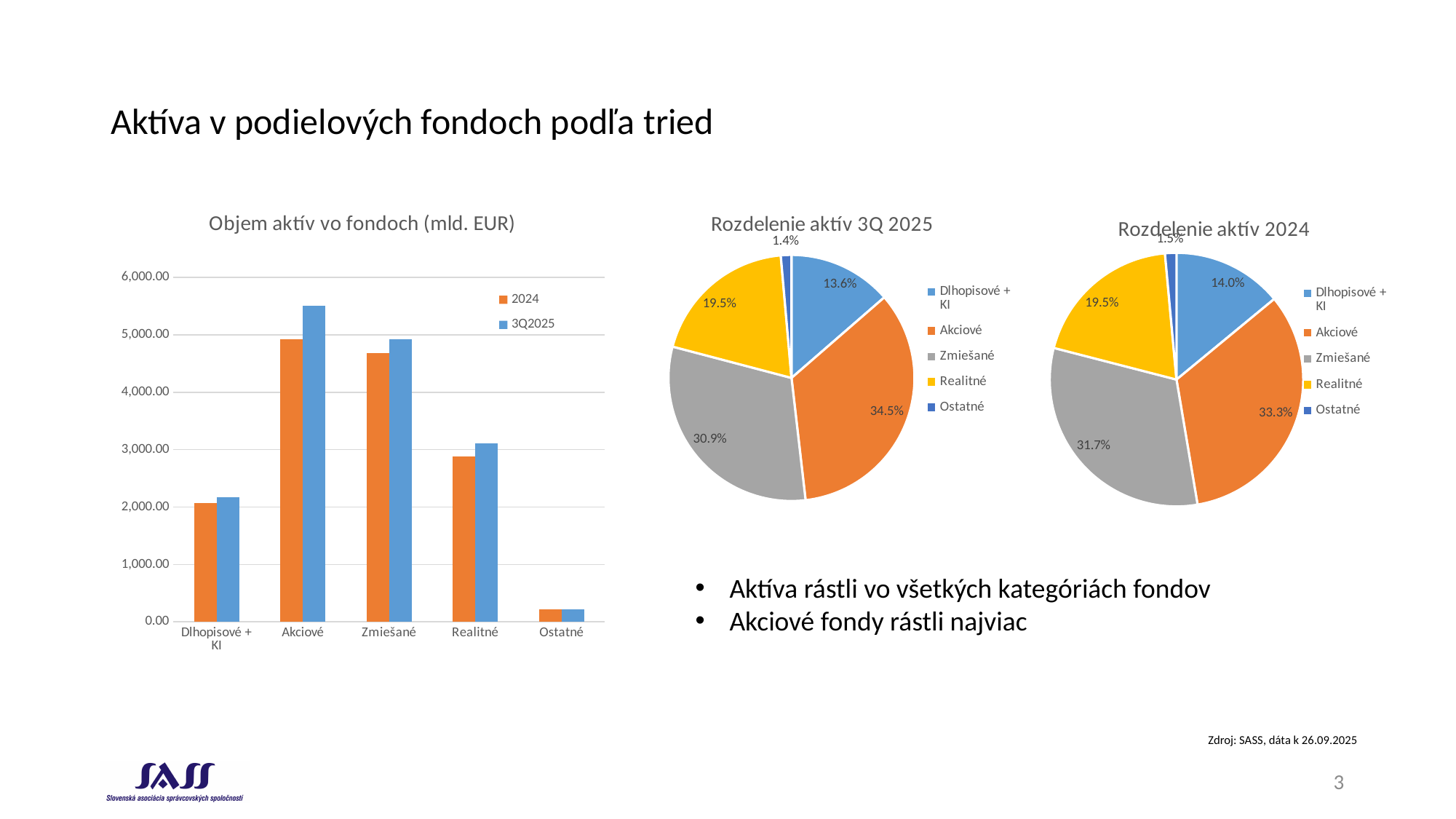
In the chart 'Objem aktív vo fondoch (mld. EUR)', which category has the lowest values? Ostatné In the chart 'Rozdelenie aktív 3Q 2025', what share do Akciové funds have? 34.5% What kind of chart is 'Objem aktív vo fondoch (mld. EUR)'? Bar chart In the chart 'Objem aktív vo fondoch (mld. EUR)', is the 3Q2025 value for Akciové greater or less than 5,000.00? greater In the chart 'Rozdelenie aktív 2024', what share do Zmiešané funds have? 31.7% In the chart 'Objem aktív vo fondoch (mld. EUR)', how many series does the legend list? 2 In the chart 'Rozdelenie aktív 2024', what share do Dlhopisové + KI funds have? 14.0% In the chart 'Objem aktív vo fondoch (mld. EUR)', is the 2024 value for Ostatné greater or less than 1,000.00? less In the chart 'Rozdelenie aktív 3Q 2025', what is the difference between the shares of Akciové and Zmiešané? 3.6% In the chart 'Rozdelenie aktív 2024', which category has the largest share? Akciové In the chart 'Rozdelenie aktív 3Q 2025', which category has the smallest share? Ostatné In the chart 'Objem aktív vo fondoch (mld. EUR)', how many categories are shown on the x axis? 5